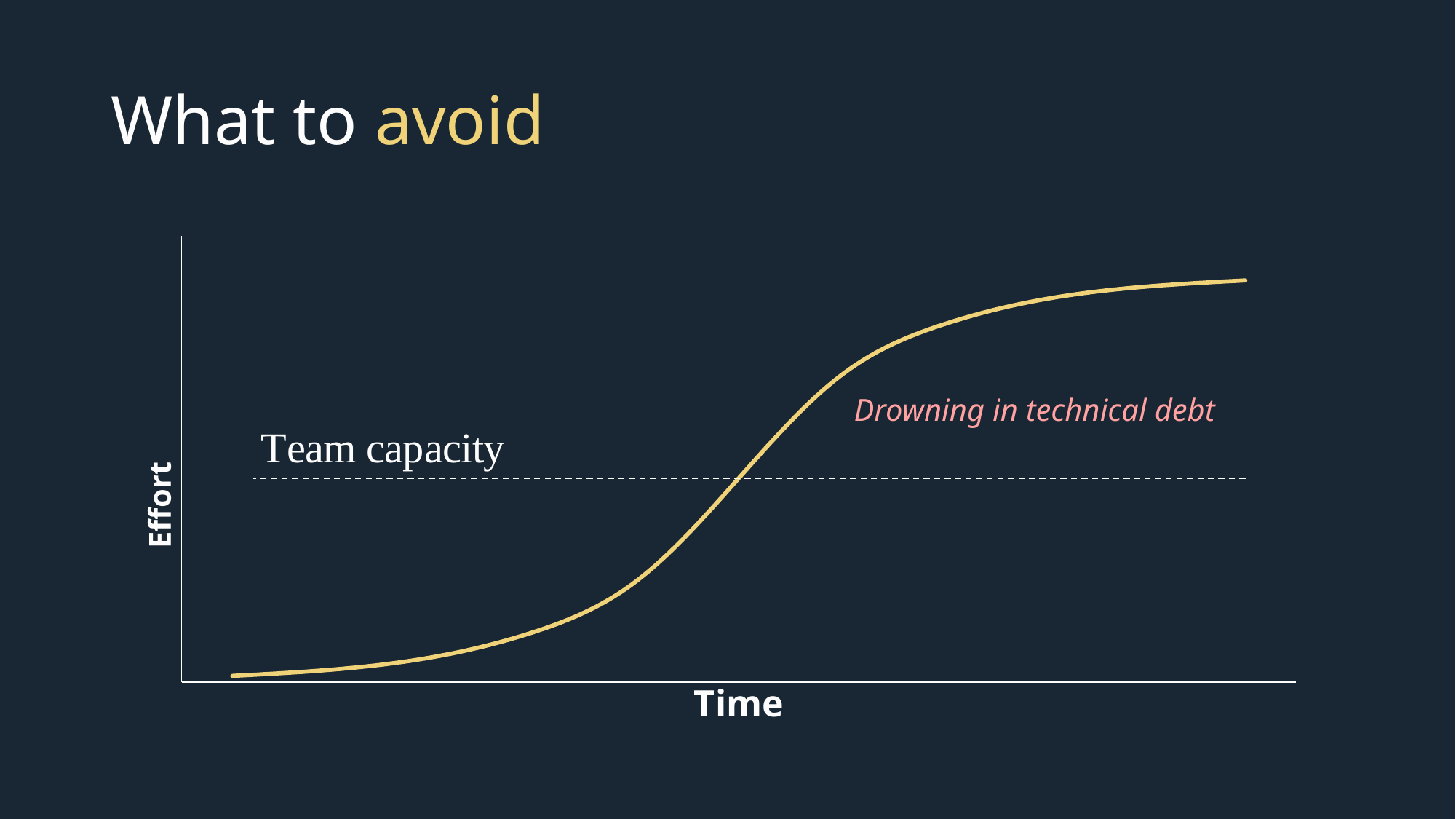
At the right end of the chart, is the Effort curve above or below the Team capacity line? Above What label is given to the dashed horizontal line on the chart? Team capacity At the left end of the chart, is the Effort curve above or below the Team capacity line? Below What is the label on the vertical axis of the chart? Effort Does the Effort curve rise or fall as Time increases along the x axis? Rises What kind of chart is shown on the slide? Line chart